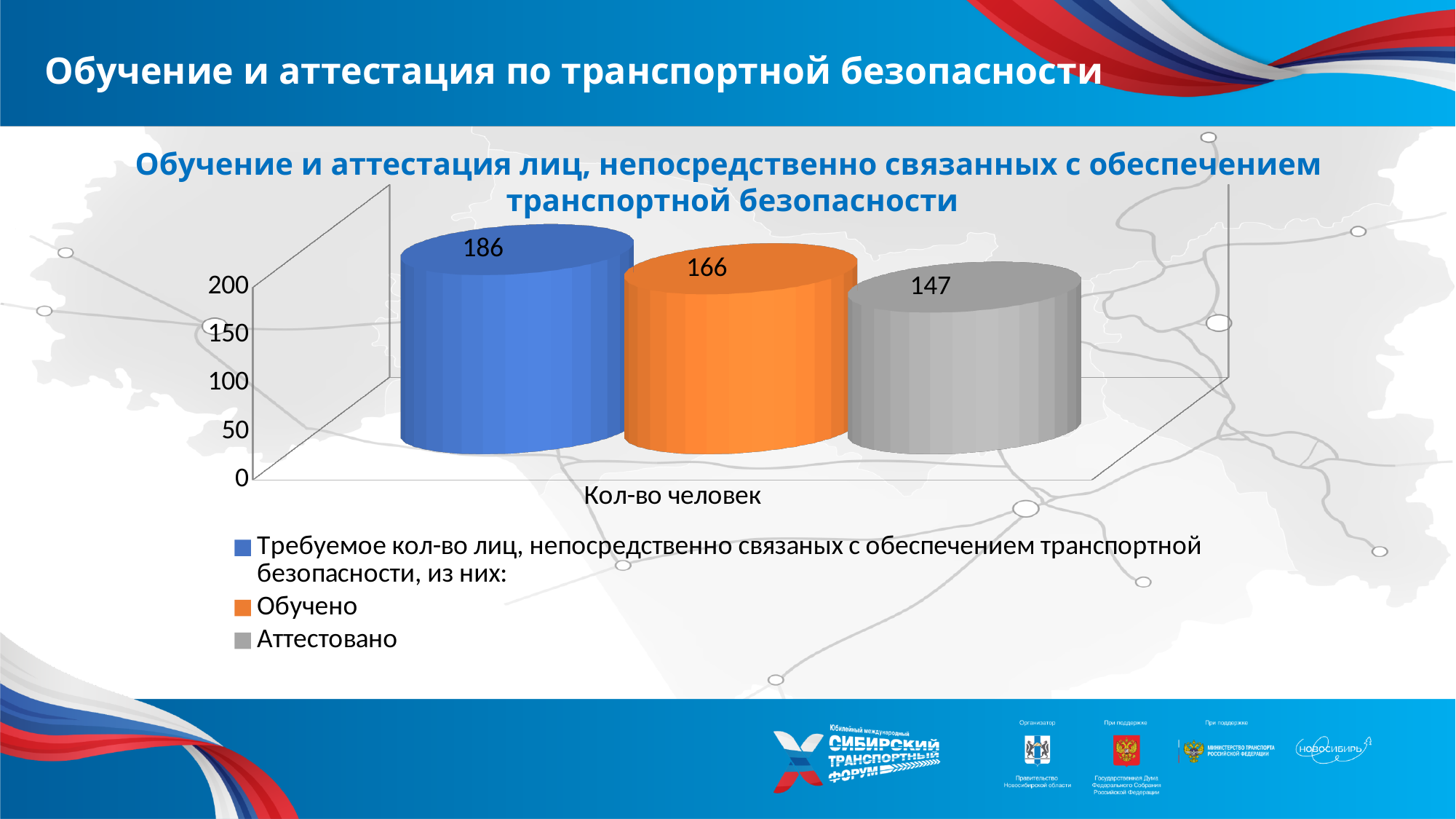
What is the value for "Требуемое кол-во лиц, непосредственно связаных с обеспечением транспортной безопасности" in the chart? 186 What is the difference between the values for "Обучено" and "Аттестовано"? 19 What kind of chart is shown on the slide? Bar chart What is the label of the category on the x axis of the chart? Кол-во человек How many series does the legend list? 3 What is the value for "Обучено" in the chart? 166 Which is larger, the value for "Обучено" or the value for "Аттестовано"? Обучено What is the difference between the required number of persons (186) and the number trained ("Обучено")? 20 What is the value for "Аттестовано" in the chart? 147 Which series has the lowest value in the chart? Аттестовано Which series has the highest value in the chart? Требуемое кол-во лиц, непосредственно связаных с обеспечением транспортной безопасности Is the value for "Аттестовано" greater or less than 150? less